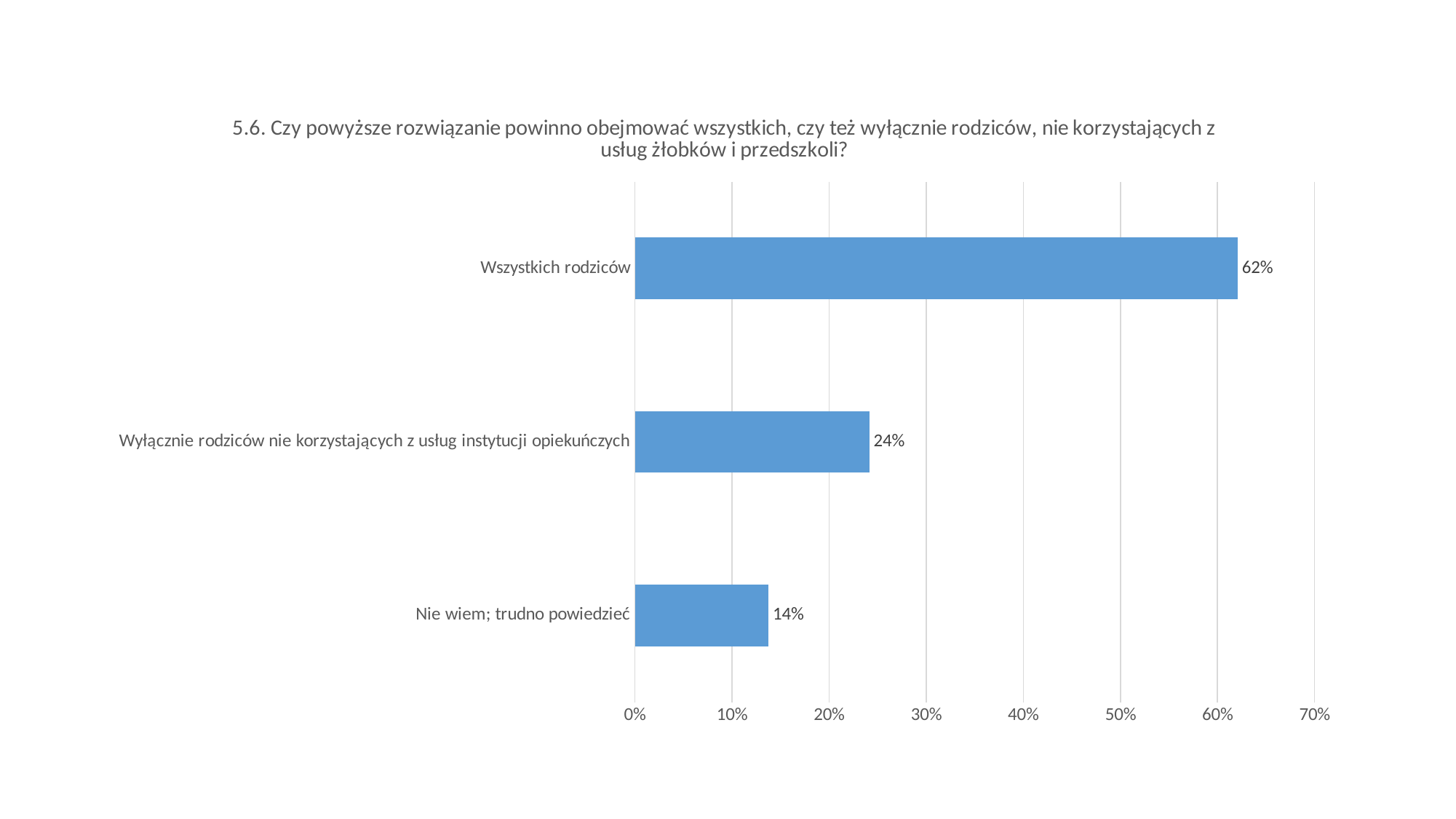
Is the value for "Wszystkich rodziców" greater or less than 50%? greater Which is larger: the value for "Wyłącznie rodziców nie korzystających z usług instytucji opiekuńczych" or for "Nie wiem; trudno powiedzieć"? Wyłącznie rodziców nie korzystających z usług instytucji opiekuńczych What is the value for "Nie wiem; trudno powiedzieć"? 14% Which category has the lowest value? Nie wiem; trudno powiedzieć What is the highest value shown on the horizontal axis? 70% What is the difference between the values for "Wszystkich rodziców" and "Wyłącznie rodziców nie korzystających z usług instytucji opiekuńczych"? 38% Which category has the highest value? Wszystkich rodziców What is the difference between the values for "Wyłącznie rodziców nie korzystających z usług instytucji opiekuńczych" and "Nie wiem; trudno powiedzieć"? 10% What kind of chart is shown on the slide? Bar chart What is the value for "Wyłącznie rodziców nie korzystających z usług instytucji opiekuńczych"? 24% How many categories are shown in the chart? 3 What is the value for "Wszystkich rodziców"? 62%